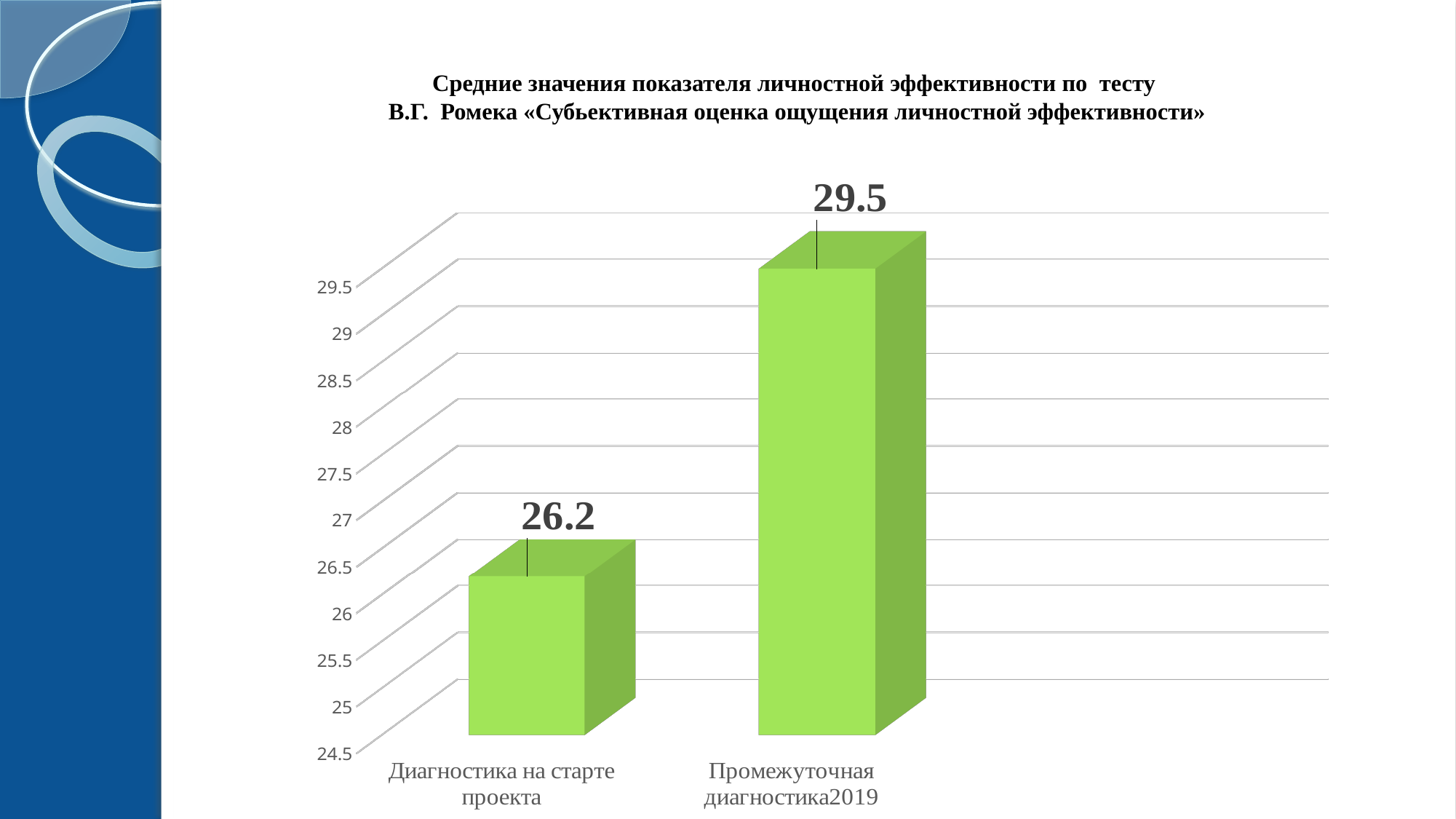
What kind of chart is shown on the slide? bar chart Which category has the lowest value? Диагностика на старте проекта What is the value for "Промежуточная диагностика2019"? 29.5 Is the value for "Промежуточная диагностика2019" greater or less than 29? greater Which is larger: the value for "Диагностика на старте проекта" or for "Промежуточная диагностика2019"? Промежуточная диагностика2019 What is the value for "Диагностика на старте проекта"? 26.2 What is the difference between the values for "Промежуточная диагностика2019" and "Диагностика на старте проекта"? 3.3 What colour are the bars in the chart? green How many categories are shown in the chart? 2 Which category has the highest value? Промежуточная диагностика2019 Is the value for "Диагностика на старте проекта" greater or less than 27? less Do the values rise or fall from the first category to the second? rise